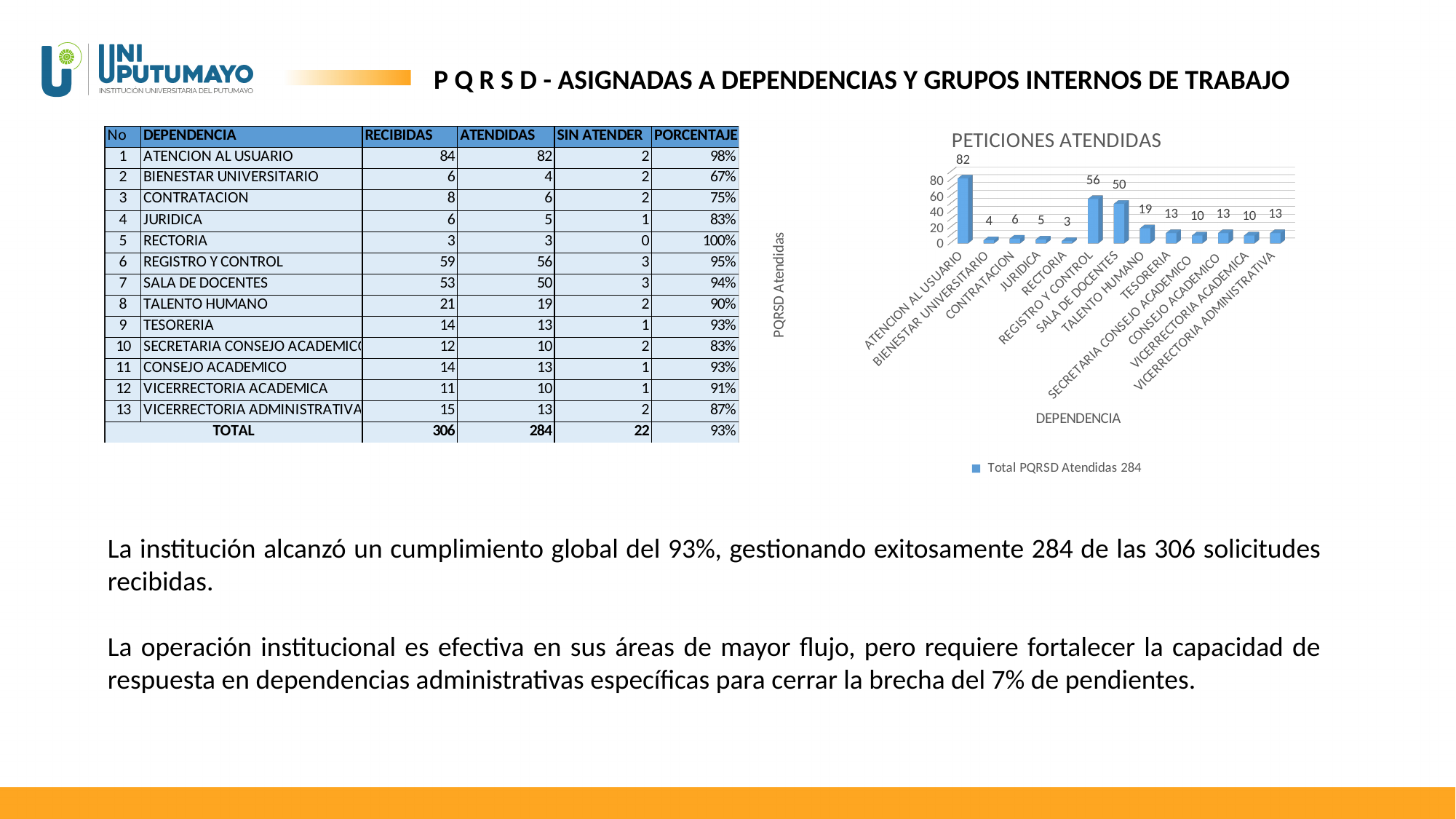
What is the legend entry of the PETICIONES ATENDIDAS chart? Total PQRSD Atendidas 284 How many dependencias are plotted in the PETICIONES ATENDIDAS chart? 13 In the PETICIONES ATENDIDAS chart, what is the value for TALENTO HUMANO? 19 In the PETICIONES ATENDIDAS chart, what is the value for ATENCION AL USUARIO? 82 Which dependencia has the lowest value in the PETICIONES ATENDIDAS chart? RECTORIA What type of chart is shown under the title PETICIONES ATENDIDAS? bar chart How many series does the legend of the PETICIONES ATENDIDAS chart list? 1 Which dependencia has the highest value in the PETICIONES ATENDIDAS chart? ATENCION AL USUARIO In the PETICIONES ATENDIDAS chart, what is the value for RECTORIA? 3 In the PETICIONES ATENDIDAS chart, what is the value for REGISTRO Y CONTROL? 56 In the PETICIONES ATENDIDAS chart, which is larger: the value for TALENTO HUMANO or the value for TESORERIA? TALENTO HUMANO In the PETICIONES ATENDIDAS chart, what is the difference between the values for REGISTRO Y CONTROL and SALA DE DOCENTES? 6